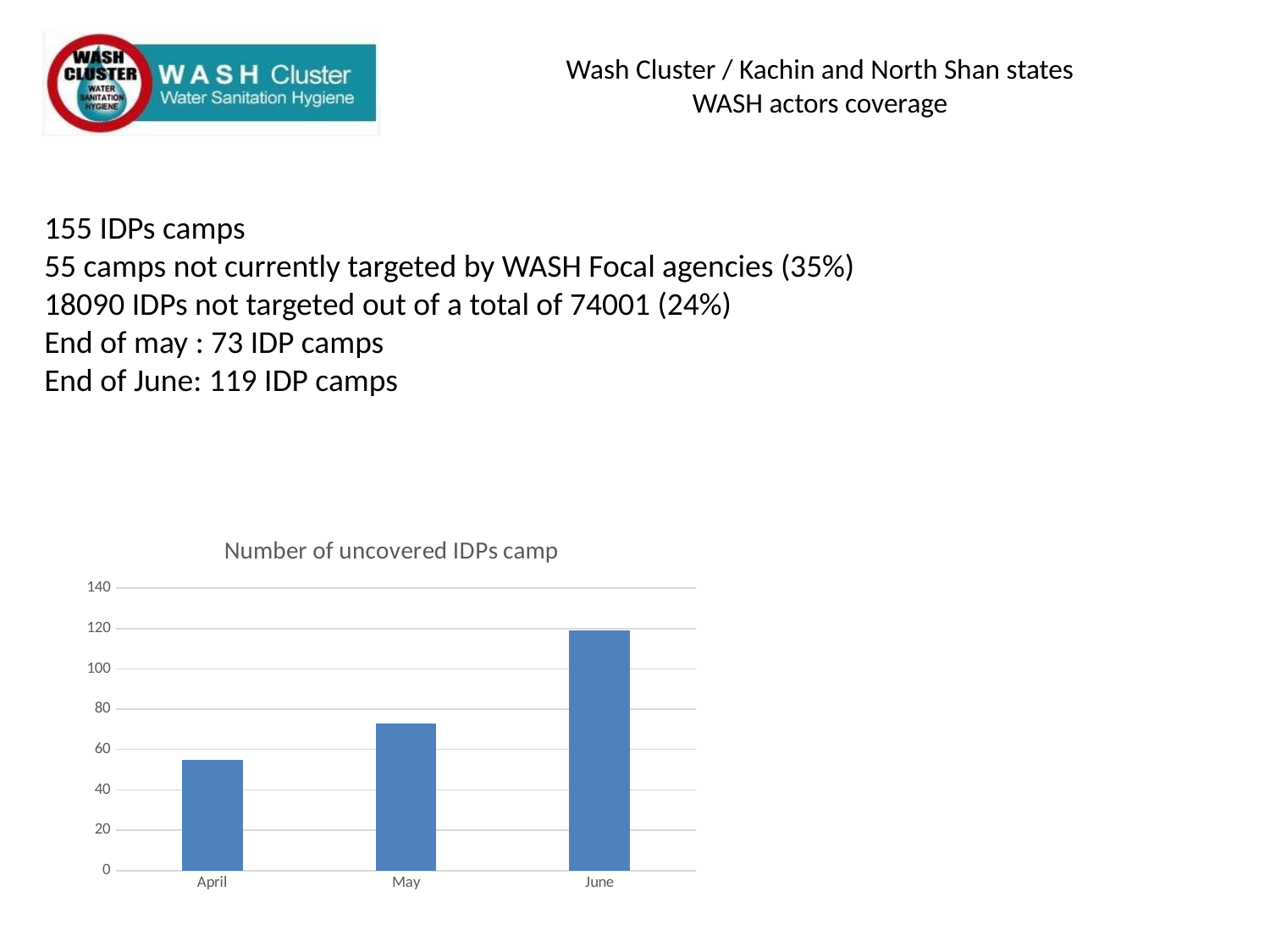
Do the values rise or fall from April to June? rise Which month has the highest number of uncovered IDPs camps? June What is the title of the chart? Number of uncovered IDPs camp Is the value for May greater or less than 80? less How many months are shown on the x axis of the chart? 3 Which month has the lowest number of uncovered IDPs camps? April Which is larger, the value for May or the value for June? June Is the value for May greater or less than 60? greater Is the value for April greater or less than 60? less What is the highest value shown on the y axis of the chart? 140 What kind of chart is shown on the slide? bar chart